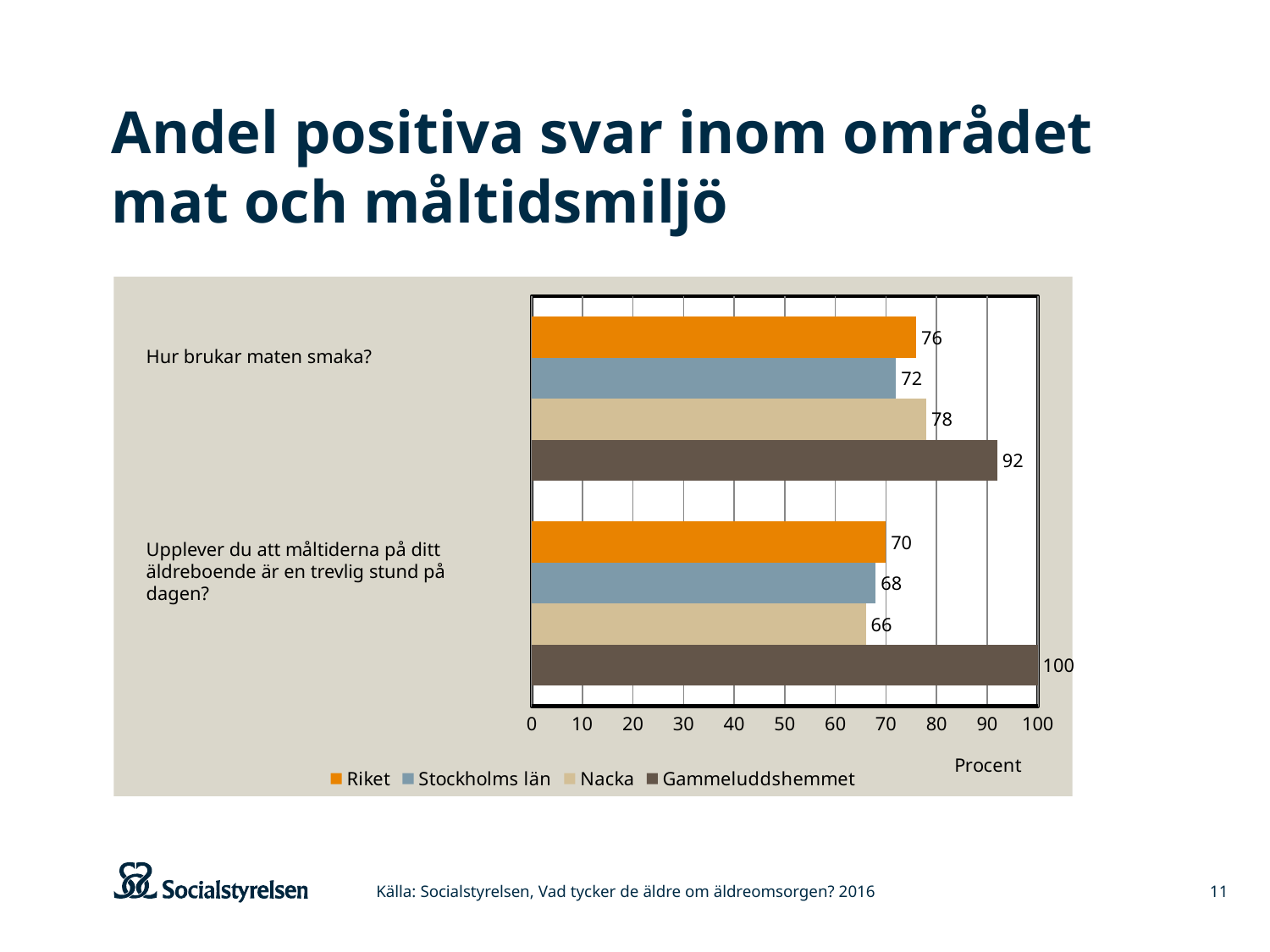
Which is larger for "Hur brukar maten smaka?": Nacka or Riket? Nacka What is the value for Stockholms län for "Upplever du att måltiderna på ditt äldreboende är en trevlig stund på dagen?"? 68 What is the difference between Gammeluddshemmet and Riket for "Hur brukar maten smaka?"? 16 Which series has the lowest value for "Hur brukar maten smaka?"? Stockholms län What kind of chart is shown on the slide? Bar chart What unit is shown on the x axis of the chart? Procent What is the difference between Gammeluddshemmet and Nacka for "Upplever du att måltiderna på ditt äldreboende är en trevlig stund på dagen?"? 34 What is the value for Riket for "Hur brukar maten smaka?"? 76 What is the value for Nacka for "Upplever du att måltiderna på ditt äldreboende är en trevlig stund på dagen?"? 66 Which series has the highest value for "Upplever du att måltiderna på ditt äldreboende är en trevlig stund på dagen?"? Gammeluddshemmet What is the value for Gammeluddshemmet for "Hur brukar maten smaka?"? 92 How many series does the legend list? 4